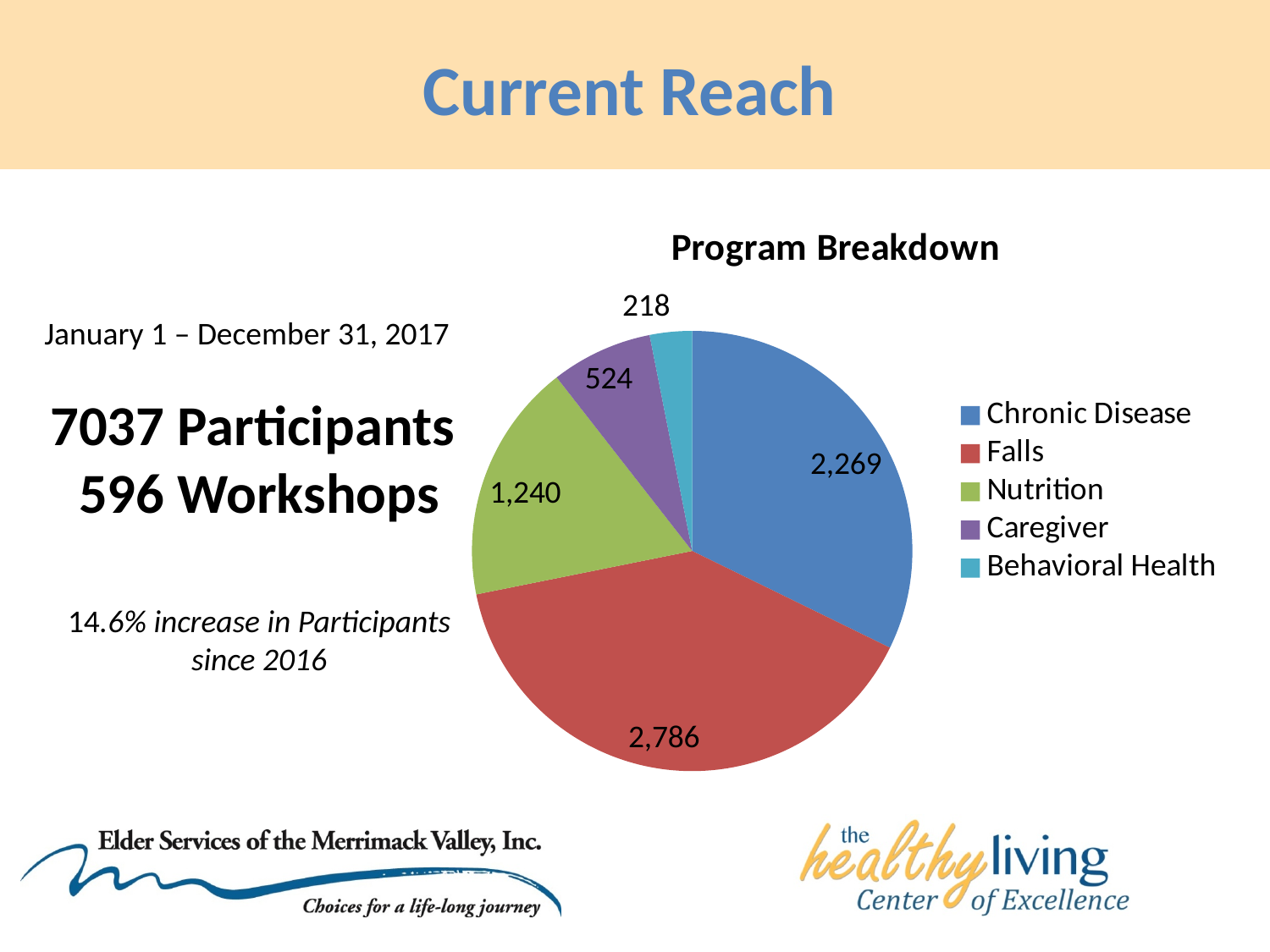
What is the value for Nutrition in the Program Breakdown pie chart? 1,240 What is the value for Behavioral Health in the Program Breakdown pie chart? 218 Which program has the largest slice in the Program Breakdown pie chart? Falls In the Program Breakdown pie chart, which is larger: Nutrition or Caregiver? Nutrition Which program has the smallest slice in the Program Breakdown pie chart? Behavioral Health What is the value for Chronic Disease in the Program Breakdown pie chart? 2,269 What is the difference between the Caregiver and Behavioral Health values in the Program Breakdown pie chart? 306 What is the total of all slices in the Program Breakdown pie chart? 7,037 What is the difference between the Falls and Chronic Disease values in the Program Breakdown pie chart? 517 What is the value for Falls in the Program Breakdown pie chart? 2,786 How many categories does the Program Breakdown pie chart show? 5 What type of chart is used for the Program Breakdown? Pie chart